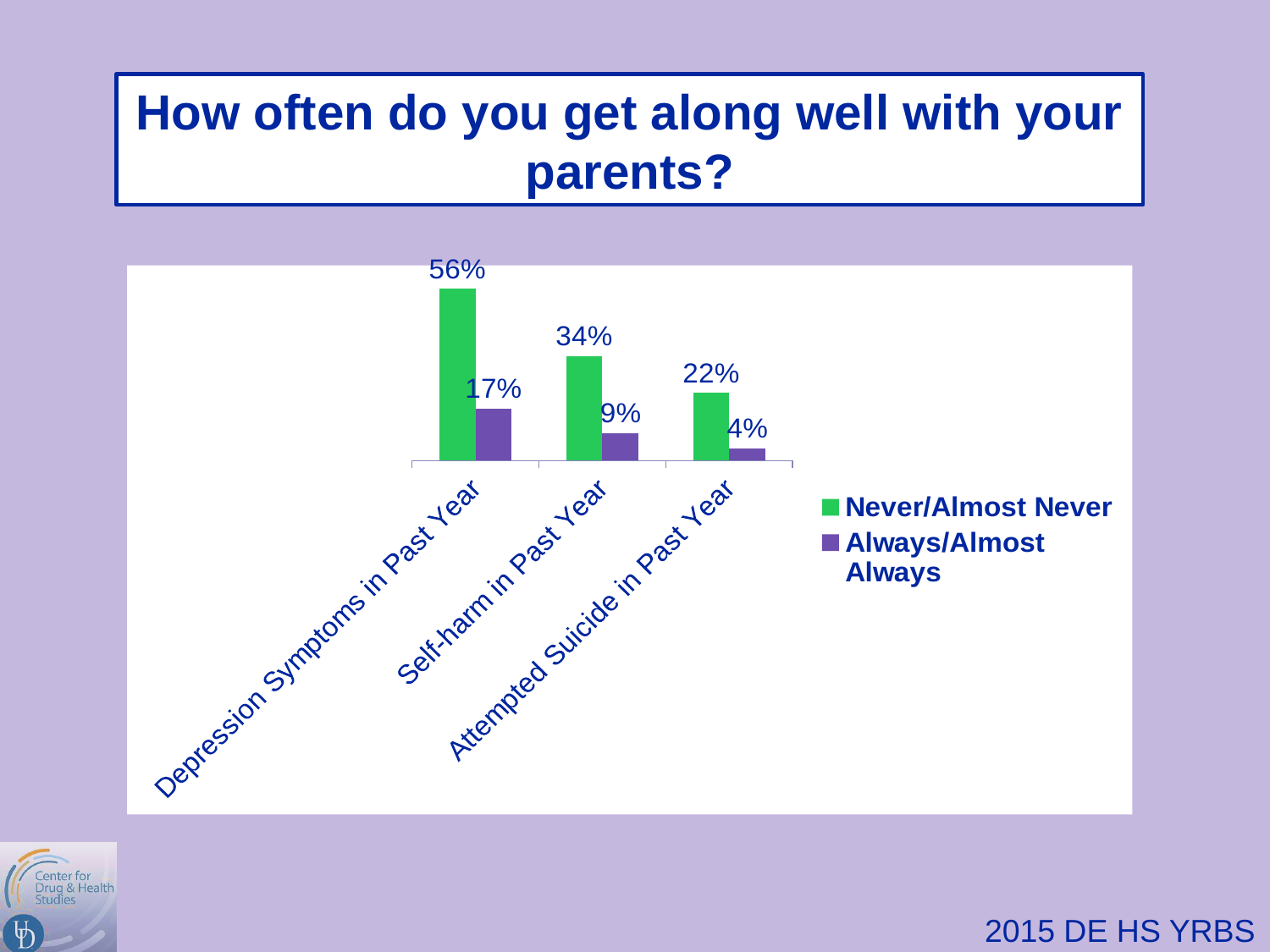
How many series does the legend list? 2 What is the Always/Almost Always value for Attempted Suicide in Past Year? 4% Which category has the highest Never/Almost Never value? Depression Symptoms in Past Year Which is larger: the Never/Almost Never value for Self-harm in Past Year or the Always/Almost Always value for Depression Symptoms in Past Year? Never/Almost Never value for Self-harm in Past Year How many categories are shown on the x axis? 3 What is the difference between the Never/Almost Never values for Self-harm in Past Year and Attempted Suicide in Past Year? 12% What is the Never/Almost Never value for Depression Symptoms in Past Year? 56% What is the difference between the Never/Almost Never and Always/Almost Always values for Depression Symptoms in Past Year? 39% What is the Always/Almost Always value for Self-harm in Past Year? 9% What kind of chart is shown on the slide? Bar chart Which colour represents the Always/Almost Always series? Purple Which category has the lowest Always/Almost Always value? Attempted Suicide in Past Year